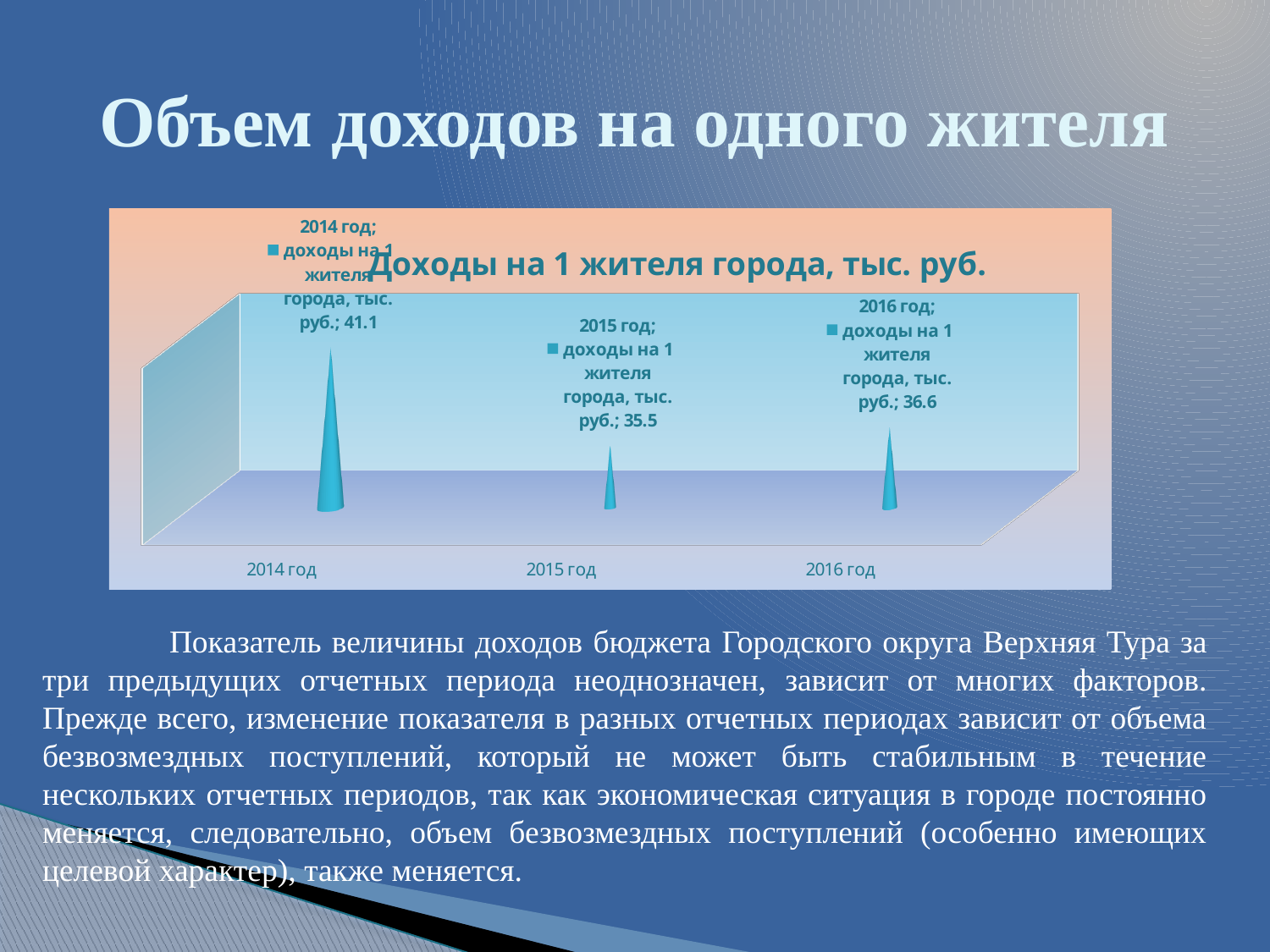
How many years are shown on the x axis? 3 Which is larger, the value for 2016 год or the value for 2015 год? 2016 год What is the value for 2015 год? 35.5 Does the value rise or fall from 2014 год to 2015 год? fall What is the value for 2014 год? 41.1 What is the difference between the values for 2016 год and 2015 год? 1.1 How many data series does the chart show? 1 Which year has the lowest value? 2015 год What is the title of the chart? Доходы на 1 жителя города, тыс. руб. What is the difference between the values for 2014 год and 2015 год? 5.6 Which year has the highest value? 2014 год What is the value for 2016 год? 36.6